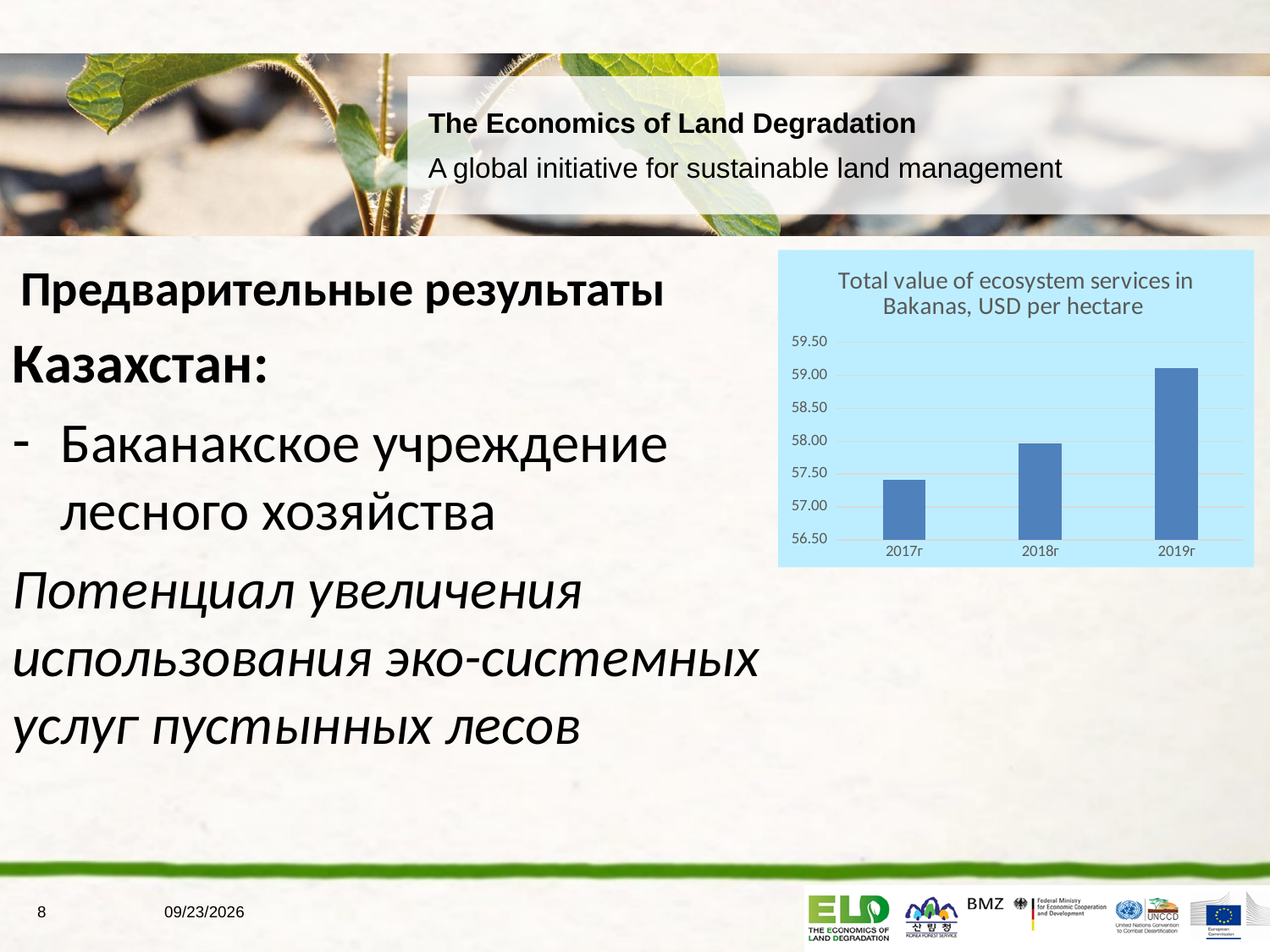
Is the value for 2017г greater or less than 57.50? less Which year has the highest total value of ecosystem services in Bakanas? 2019г Is the value for 2018г greater or less than 57.50? greater Is the value for 2019г greater or less than 58.50? greater How many years are shown on the x axis of the chart? 3 Do the values rise or fall from 2017г to 2019г? rise What is the title of the chart? Total value of ecosystem services in Bakanas, USD per hectare Which year has the lowest total value of ecosystem services in Bakanas? 2017г Which is larger, the value for 2017г or the value for 2018г? 2018г Which is larger, the value for 2017г or the value for 2019г? 2019г What kind of chart is shown on the slide? bar chart